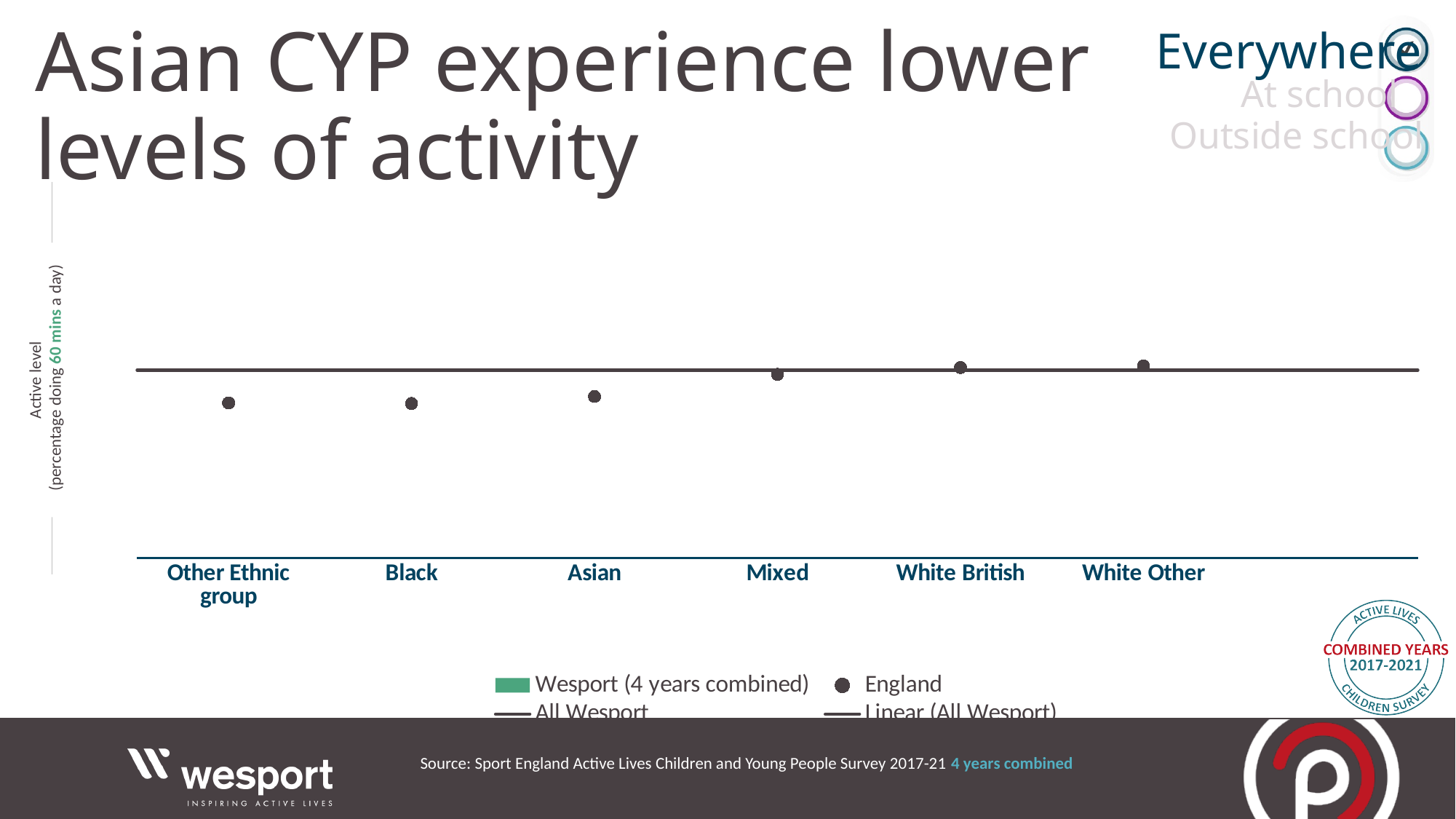
Is the England dot for Asian above or below the All Wesport line? below What is the label of the y axis of the chart? Active level (percentage doing 60 mins a day) Which category is listed first on the x axis of the chart? Other Ethnic group Is the England value for Mixed higher or lower than the England value for Asian? higher How many ethnic group categories are shown on the x axis of the chart? 6 How many series does the chart legend list? 4 Is the England value for Black higher or lower than the England value for White British? lower Which series in the chart is plotted as dots? England Do the England values generally rise or fall moving from Other Ethnic group to White Other along the x axis? rise